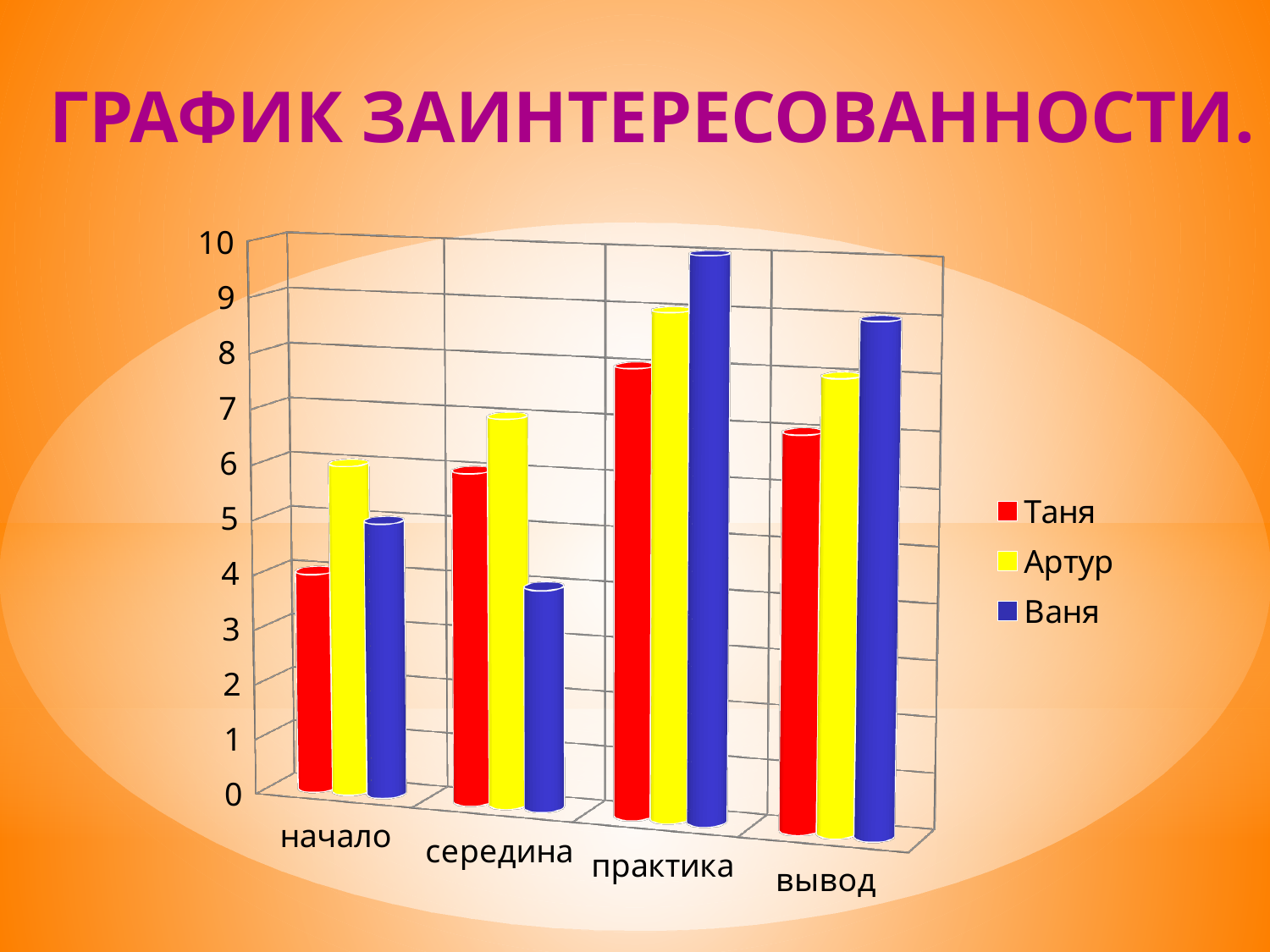
In which category is the bar for Ваня the highest? практика In the начало category, which is larger: the bar for Артур or the bar for Таня? Артур Which series has the highest bar in the практика category? Ваня How many series does the legend list? 3 Which colour represents Ваня in the legend? blue Is the value for Ваня in the практика category greater or less than 9? greater How many categories are shown on the x axis? 4 Which series has the lowest bar in the середина category? Ваня Which series has the lowest bar in the начало category? Таня What is the title of the slide's chart? ГРАФИК ЗАИНТЕРЕСОВАННОСТИ. Is the value for Таня in the начало category greater or less than 5? less What kind of chart is shown on the slide? bar chart